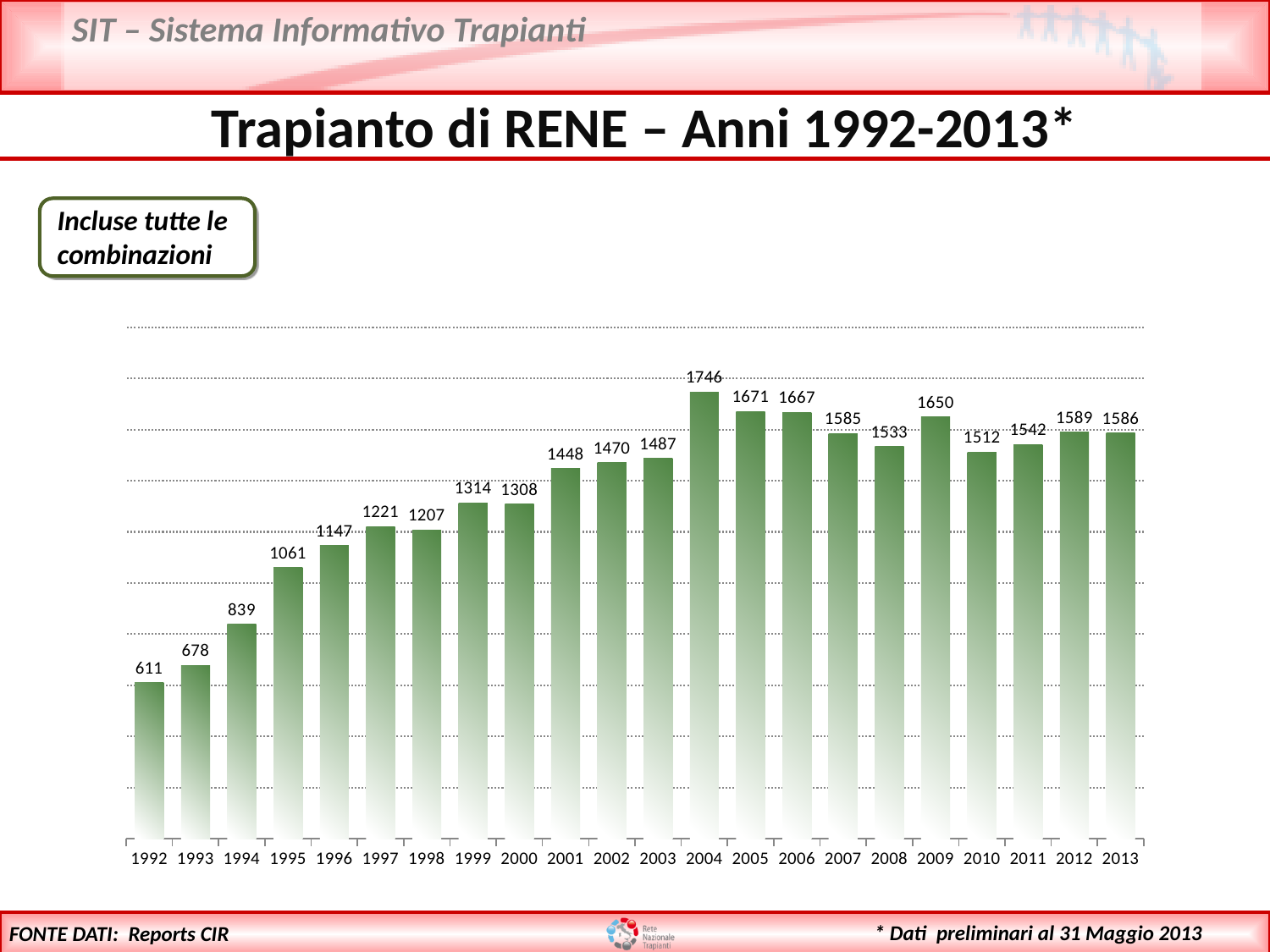
Do the values rise or fall from 1992 to 2004? rise What is the value for 2004? 1746 Which year has the lowest value? 1992 How many years are shown on the x axis? 22 What is the difference between the values for 2004 and 1992? 1135 Which year has the highest value? 2004 What is the title of the slide containing the chart? Trapianto di RENE – Anni 1992-2013* What is the difference between the values for 2012 and 2013? 3 What is the value for 2013? 1586 What is the value for 1992? 611 What kind of chart is shown on the slide? bar chart Which is larger, the value for 2009 or the value for 2010? 2009